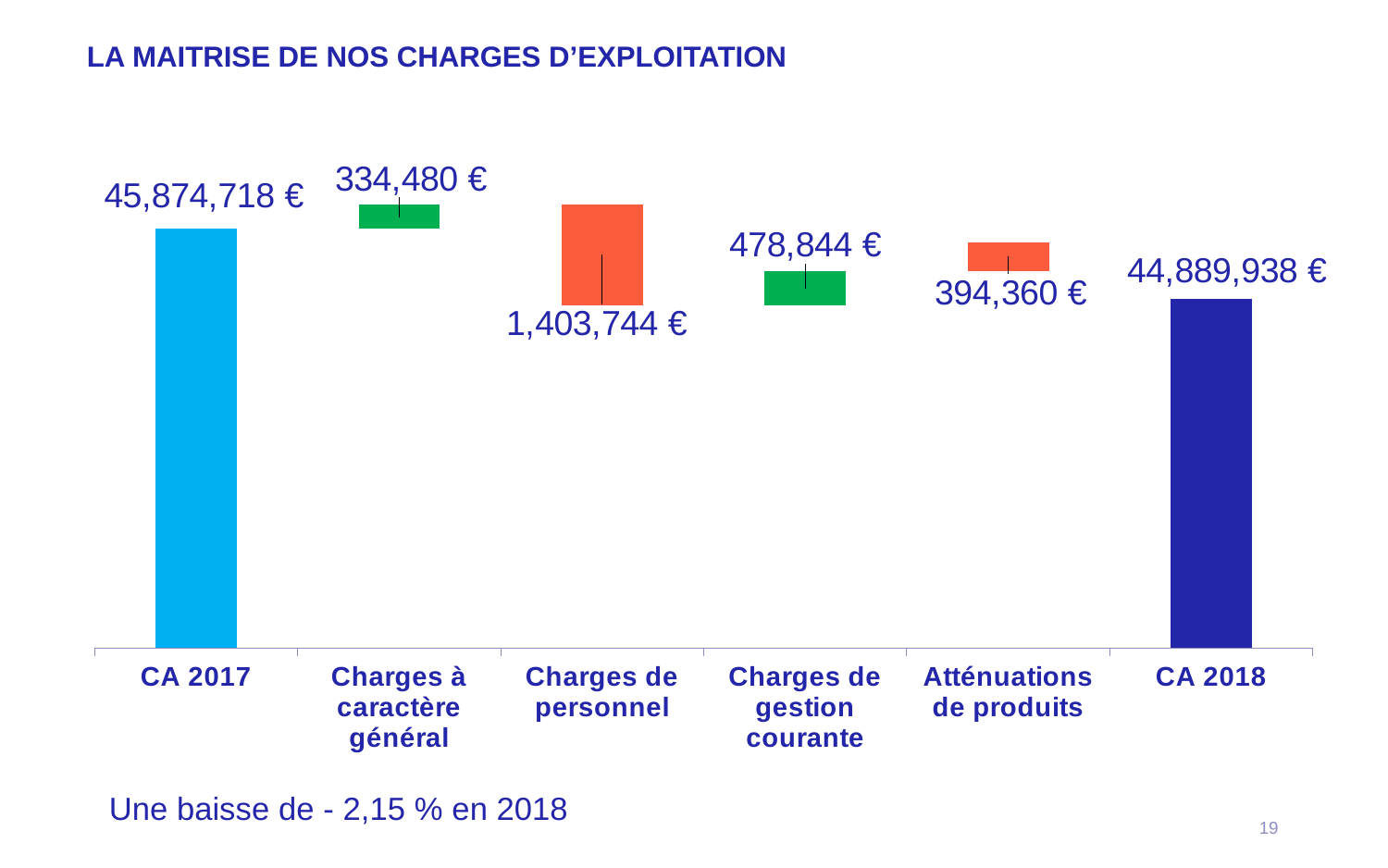
What is the value shown for Charges de personnel? 1,403,744 € What is the value shown for Charges à caractère général? 334,480 € What is the value shown for Atténuations de produits? 394,360 € Among the four charge categories between CA 2017 and CA 2018, which has the largest value? Charges de personnel How many categories are shown on the x axis of the chart? 6 What is the difference between CA 2017 and CA 2018? 984,780 € What is the value shown for CA 2017? 45,874,718 € Among the four charge categories between CA 2017 and CA 2018, which has the smallest value? Charges à caractère général What is the title of the slide containing the chart? LA MAITRISE DE NOS CHARGES D'EXPLOITATION What is the value shown for CA 2018? 44,889,938 € What is the value shown for Charges de gestion courante? 478,844 € Which is larger, Charges de gestion courante or Atténuations de produits? Charges de gestion courante